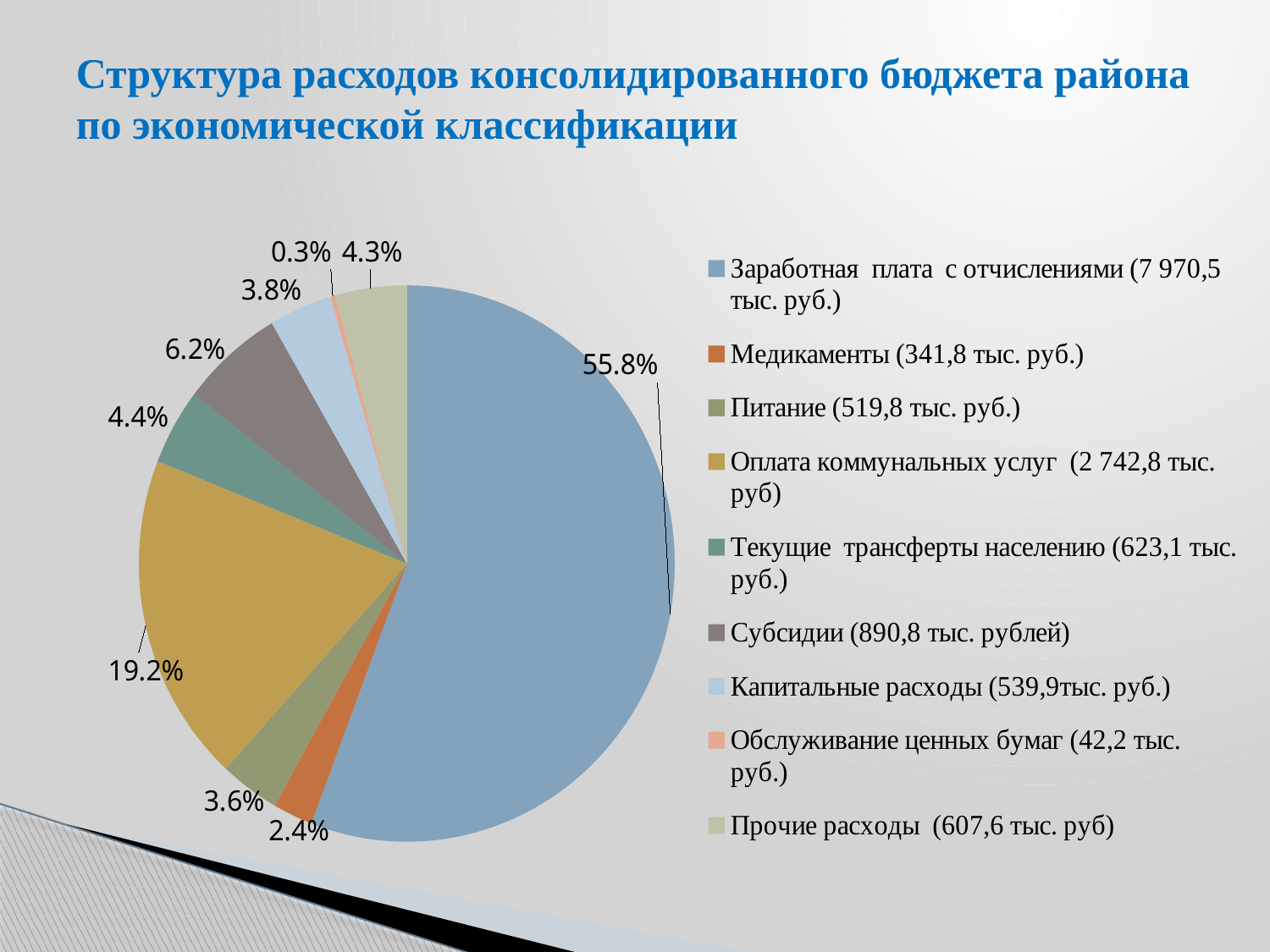
What is the difference in percentage points between "Заработная плата с отчислениями" and "Оплата коммунальных услуг"? 36.6 What amount in thousand rubles does the legend give for "Питание"? 519,8 тыс. руб. What share of the pie does "Оплата коммунальных услуг" take? 19.2% What colour is the slice for "Оплата коммунальных услуг"? gold What percentage is shown for "Медикаменты"? 2.4% What kind of chart is shown on the slide? pie chart Which is larger, the slice for "Текущие трансферты населению" or the slice for "Капитальные расходы"? Текущие трансферты населению Which category has the largest slice of the pie? Заработная плата с отчислениями What share of the pie does "Заработная плата с отчислениями" take? 55.8% What percentage is shown for "Субсидии"? 6.2% Which category has the smallest slice of the pie? Обслуживание ценных бумаг How many slices does the pie chart have? 9